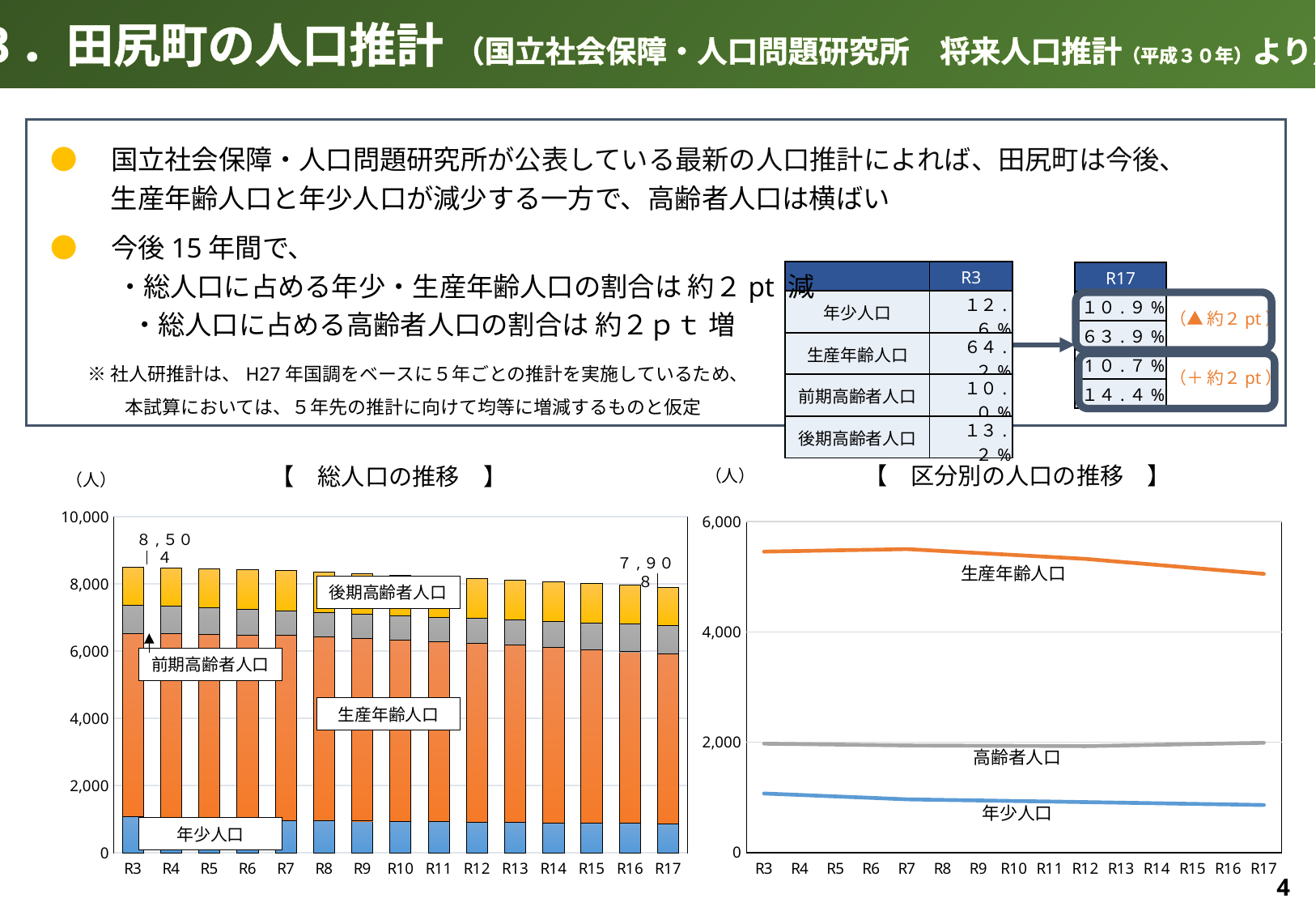
In the right chart 区分別の人口の推移, which is larger at R17: 高齢者人口 or 年少人口? 高齢者人口 In the right chart 区分別の人口の推移, is the value of 生産年齢人口 at R3 greater or less than 4,000? greater In the left chart 総人口の推移, is the total for R17 greater or less than 8,000? less In the left chart 総人口の推移, what is the total population shown for R17? 7,908 In the left chart 総人口の推移, what is the total population shown for R3? 8,504 In the left chart 総人口の推移, how many years are shown on the x axis? 15 What kind of chart is the left chart titled 総人口の推移? Stacked bar chart In the left chart 総人口の推移, does the total population rise or fall from R3 to R17? Fall In the right chart 区分別の人口の推移, how many series are plotted? 3 In the left chart 総人口の推移, by how much does the total population for R3 exceed that for R17? 596 In the right chart 区分別の人口の推移, which series has the highest values? 生産年齢人口 What kind of chart is the right chart titled 区分別の人口の推移? Line chart